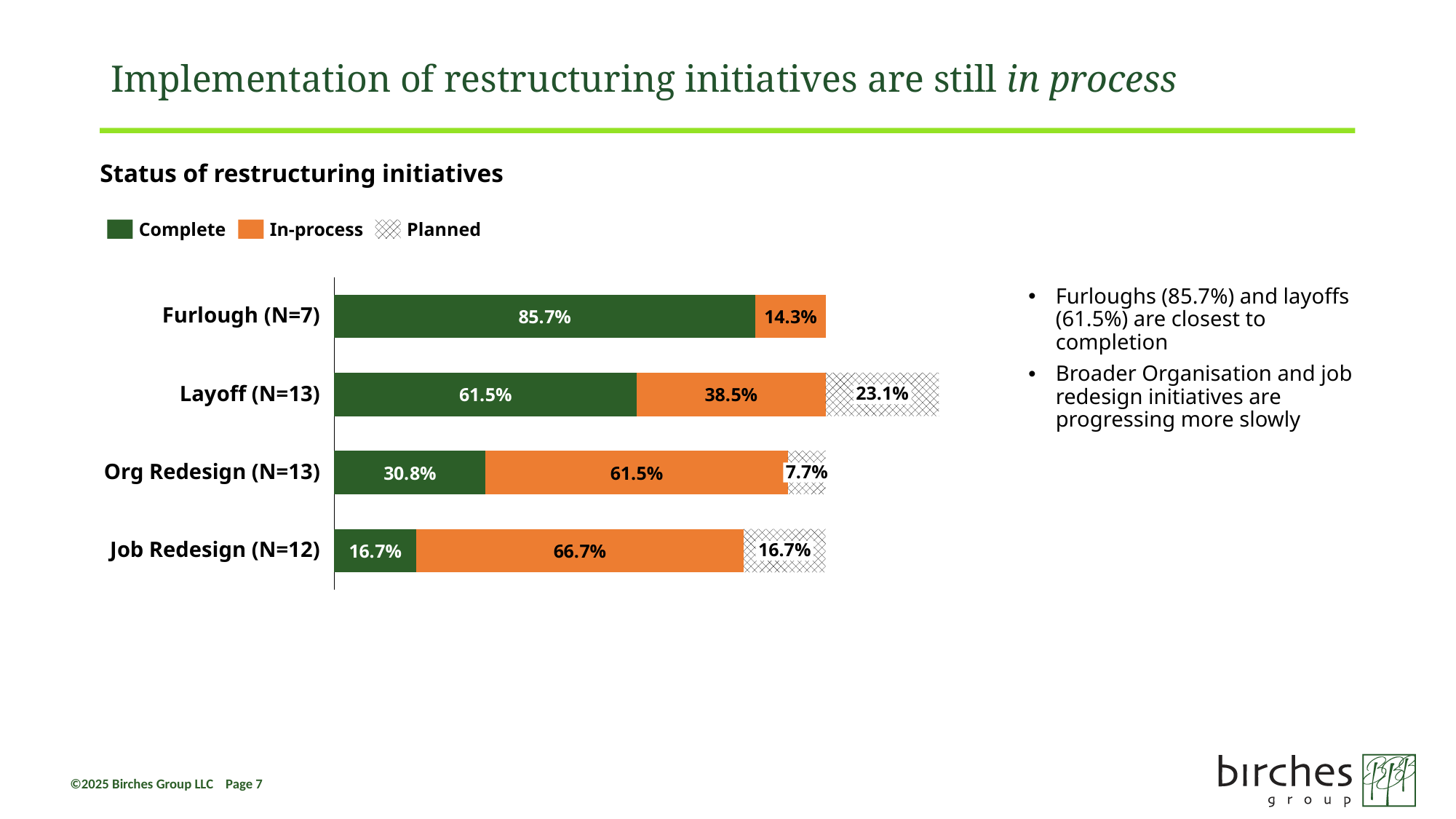
Which initiative has the highest Complete percentage? Furlough (N=7) What is the difference between the Complete percentage for Furlough and for Layoff? 24.2 percentage points How many series does the legend list? 3 What is the In-process value for Job Redesign (N=12)? 66.7% What type of chart is shown on the slide? Stacked bar chart Which initiative has the highest In-process percentage? Job Redesign (N=12) What is the Planned value for Layoff (N=13)? 23.1% Which initiative has the lowest Complete percentage? Job Redesign (N=12) What is the Planned value for Org Redesign (N=13)? 7.7% How many initiatives are shown in the chart? 4 Which has a larger In-process percentage, Org Redesign or Layoff? Org Redesign What percentage of Furlough initiatives are Complete? 85.7%